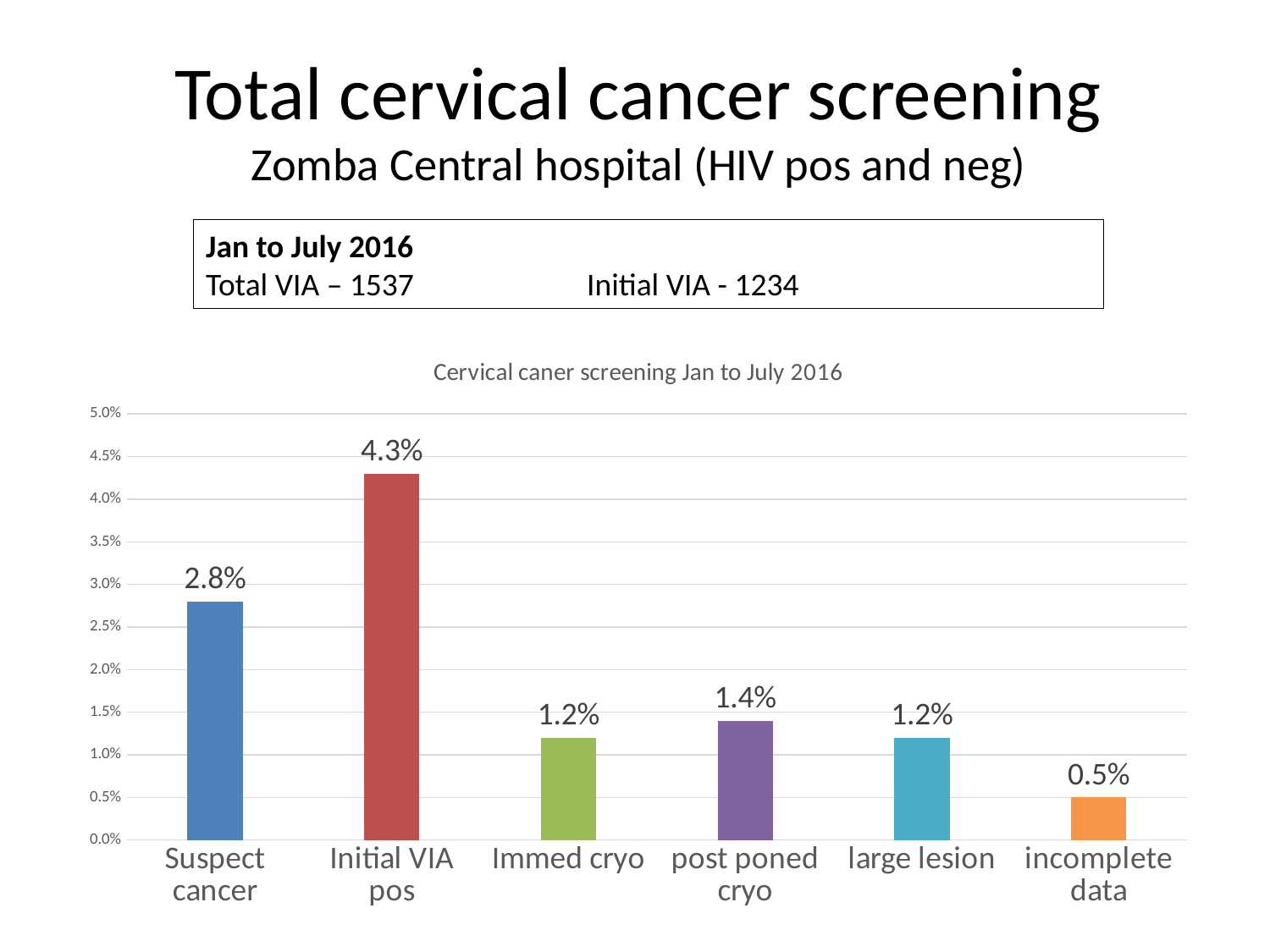
What is the value for incomplete data? 0.5% Which category has the highest value? Initial VIA pos Which is larger, the value for Suspect cancer or the value for post poned cryo? Suspect cancer What is the difference between the values for Initial VIA pos and Suspect cancer? 1.5% What kind of chart is shown on the slide? bar chart What is the value for post poned cryo? 1.4% What is the title of the chart? Cervical caner screening Jan to July 2016 What is the difference between the values for post poned cryo and large lesion? 0.2% What is the value for Suspect cancer? 2.8% Which category has the lowest value? incomplete data How many categories are shown on the x axis? 6 What is the value for Initial VIA pos? 4.3%